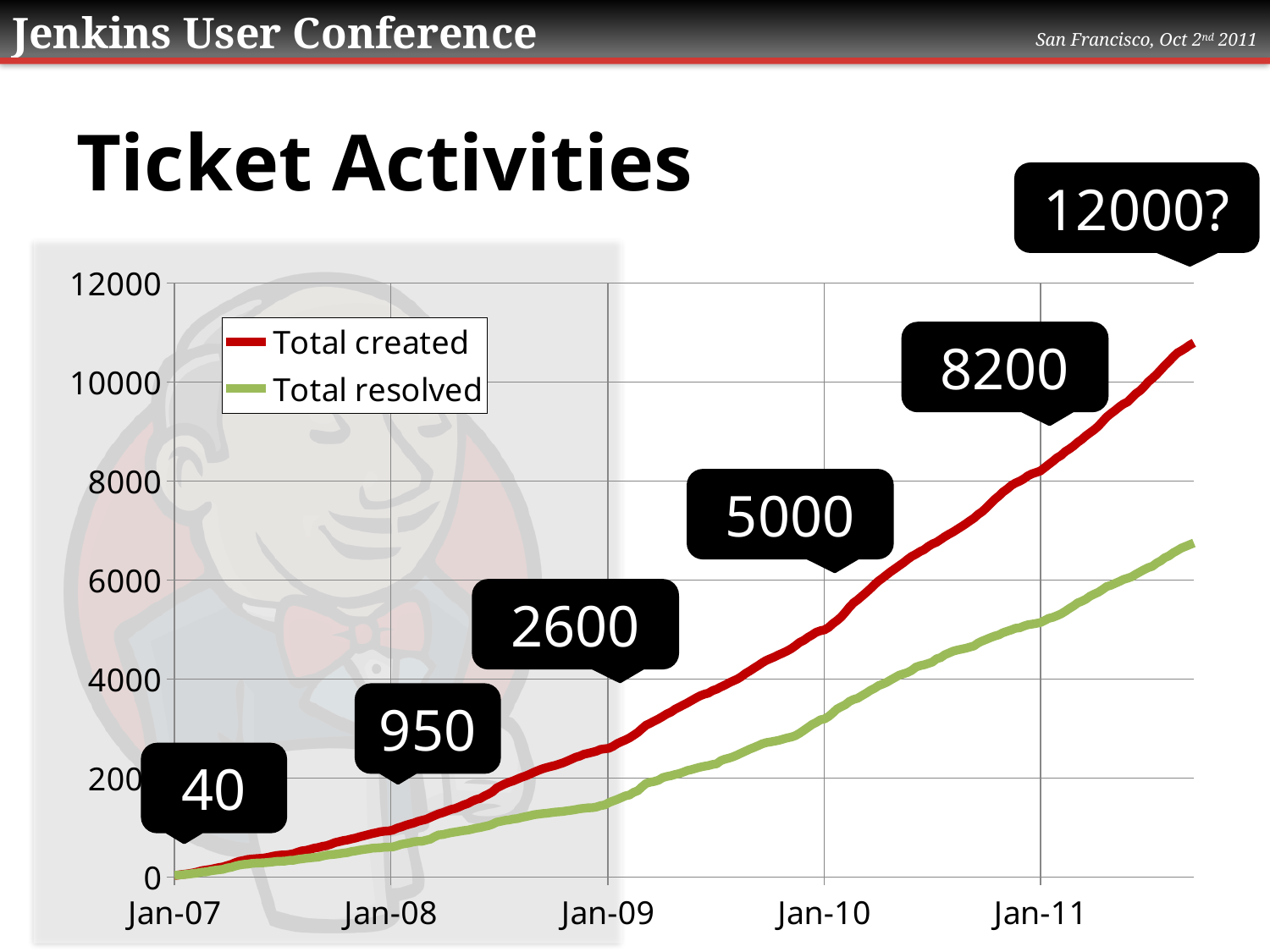
What is the title of the slide's chart section? Ticket Activities Is the value for Total resolved at Jan-11 greater or less than 6000? less What is the difference between the Total created callout values at Jan-11 and Jan-10? 3200 What value does the callout show for Total created at Jan-08? 950 Which series is higher at Jan-11, Total created or Total resolved? Total created How many series does the legend list? 2 What value does the callout show for Total created at Jan-09? 2600 Do the Total created values rise or fall from Jan-07 to Jan-11? rise What value does the callout show for Total created at Jan-10? 5000 What kind of chart is shown on the slide? line chart What value does the callout show for Total created at Jan-11? 8200 What are the two series named in the legend? Total created and Total resolved